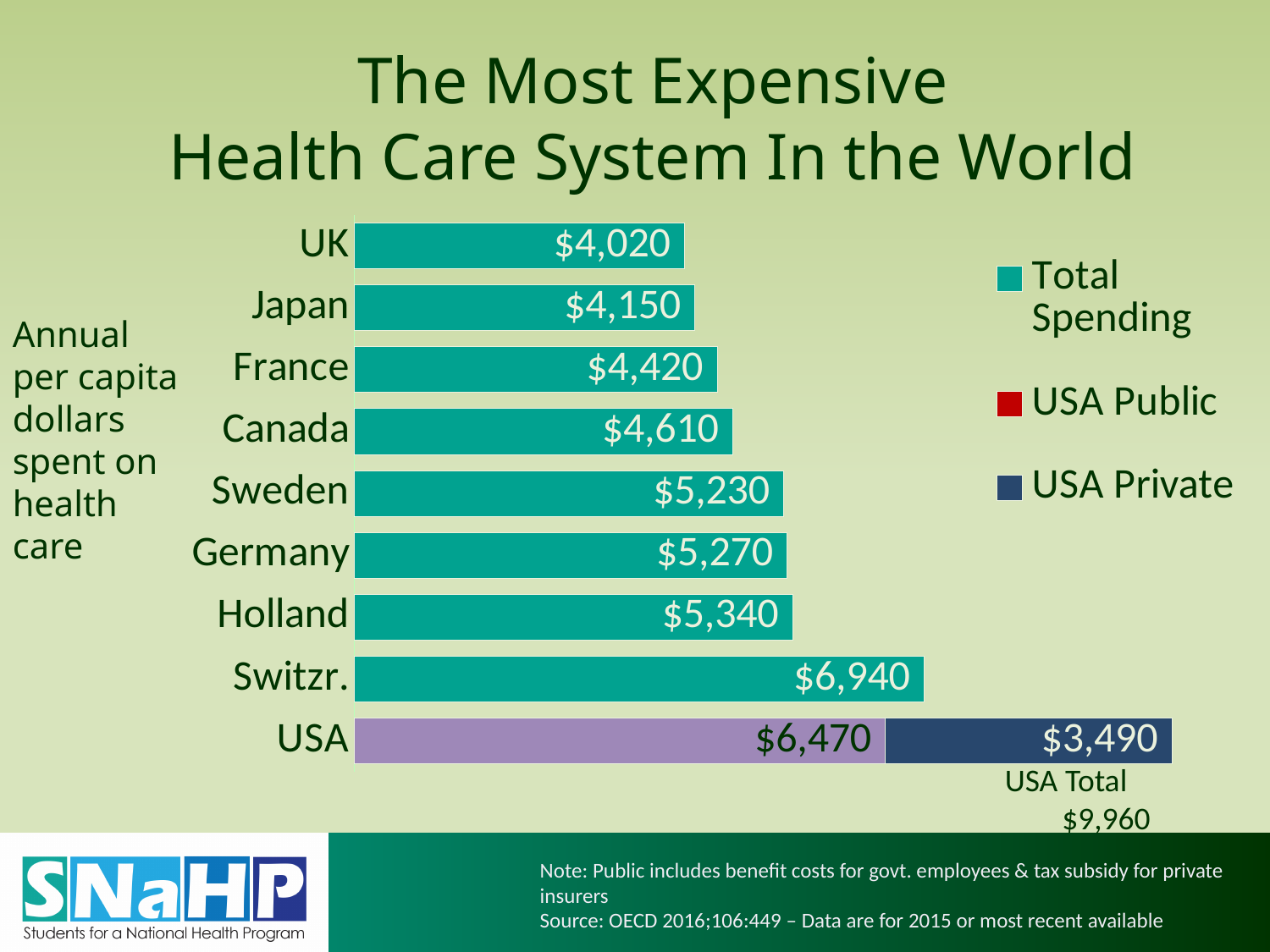
Which country has the lowest per capita spending shown? UK What kind of chart is shown on the slide? Bar chart Which has a larger value, Japan or France? France How many countries are shown on the chart? 9 What is the USA Private value shown on the USA bar? $3,490 What is the difference between the values for Switzr. and Holland? $1,600 How many series does the legend list? 3 What is the USA Public value shown on the USA bar? $6,470 What is the USA Total per capita spending shown? $9,960 Which country has the highest total per capita spending shown? USA What is the value shown for Canada? $4,610 What is the annual per capita health care spending shown for Switzr.? $6,940